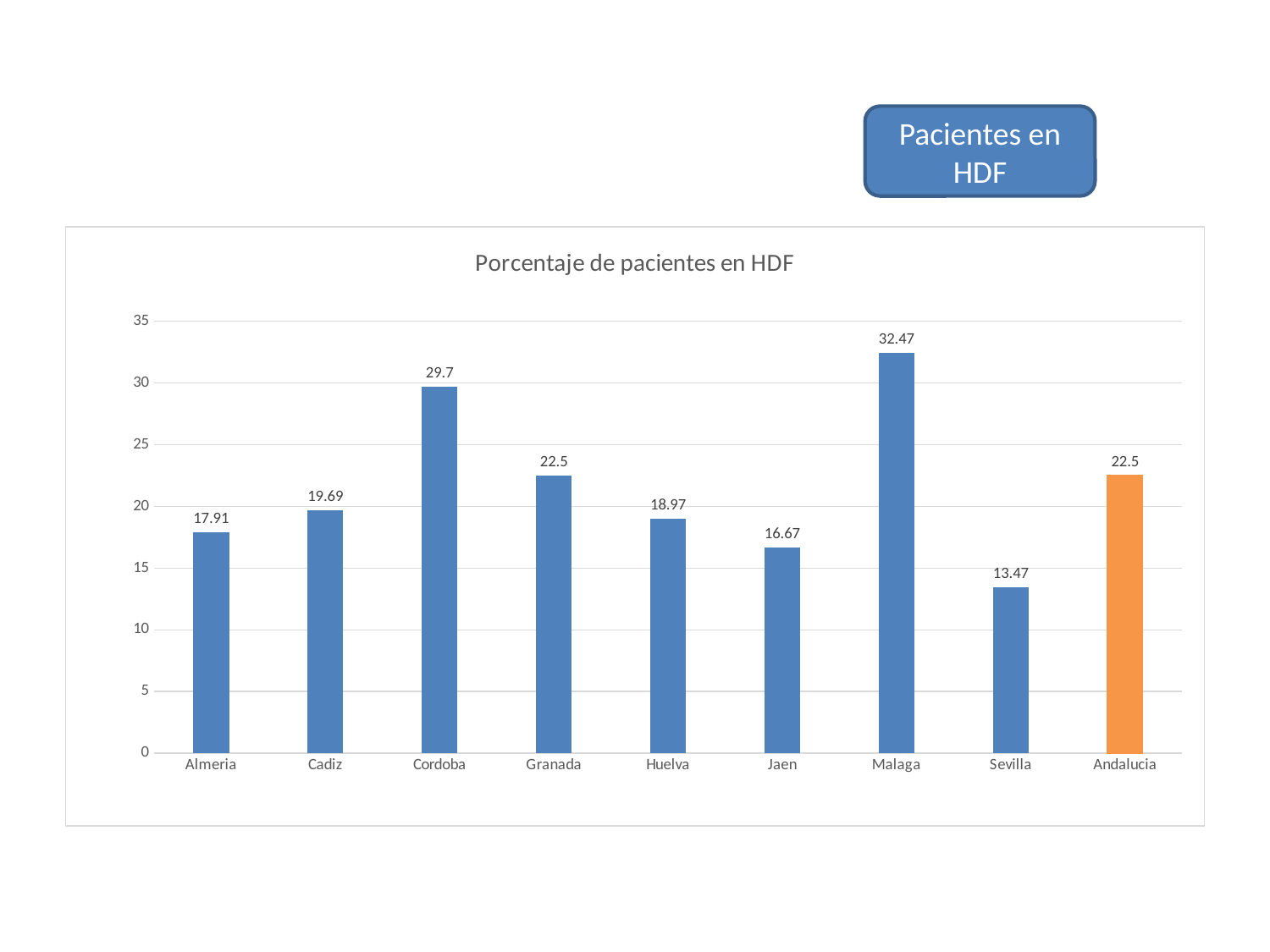
What is the title of the chart? Porcentaje de pacientes en HDF What is the difference between the values for Malaga and Sevilla? 19 Which category has the lowest value? Sevilla How many categories are shown on the x axis? 9 What kind of chart is this? bar chart What is the value for Malaga? 32.47 What is the value for Andalucia? 22.5 What is the difference between the values for Cordoba and Granada? 7.2 Which category has the highest value? Malaga Is the value for Jaen greater or less than 20? less Which is larger, the value for Cadiz or the value for Huelva? Cadiz What is the value for Sevilla? 13.47